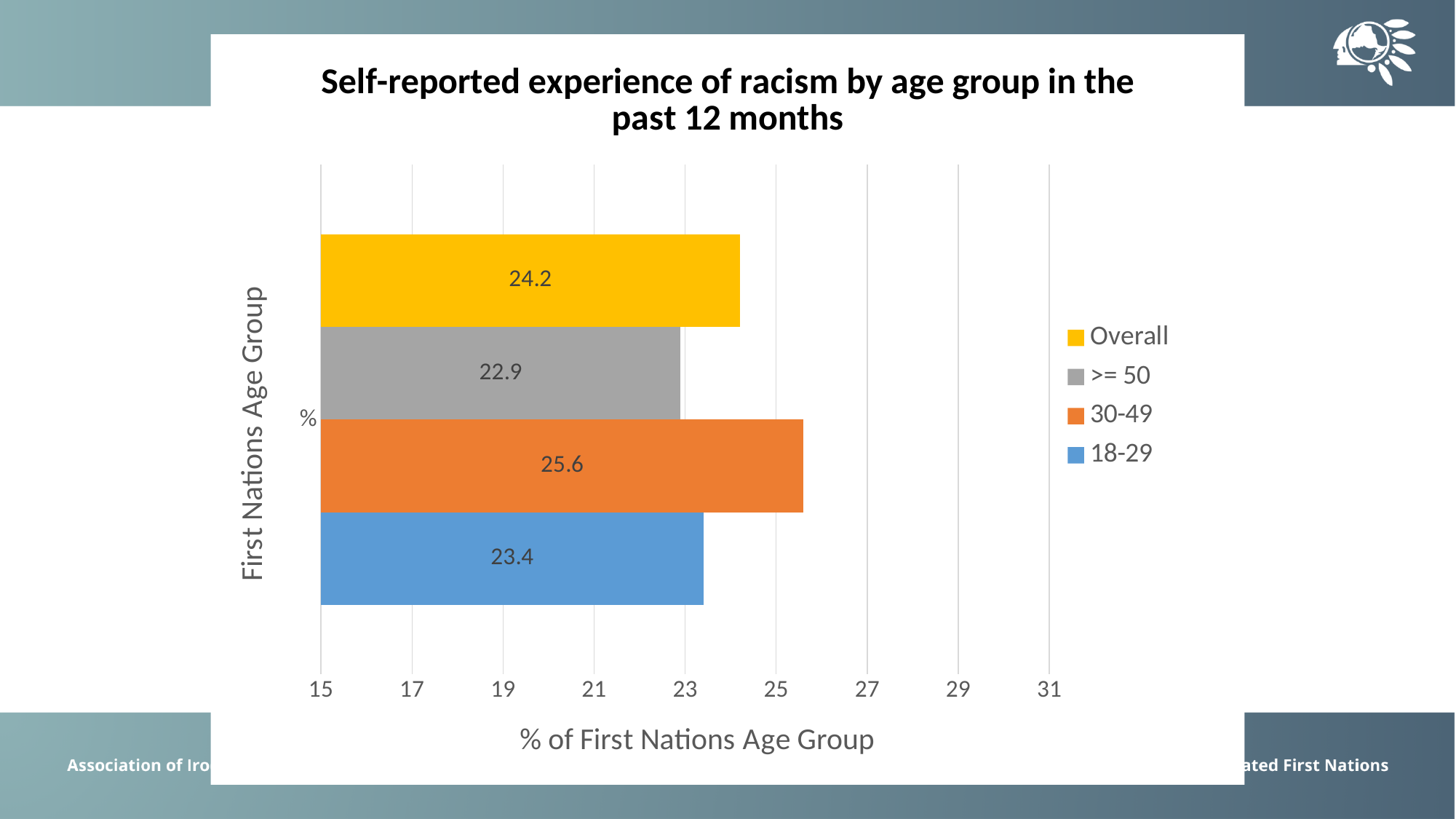
Which series has the lowest value? >= 50 What is the Overall value shown on the chart? 24.2 What is the value for the >= 50 age group? 22.9 What is the title of the chart? Self-reported experience of racism by age group in the past 12 months What colour is the bar for the 30-49 age group? Orange Which series has the highest value? 30-49 What is the difference between the 30-49 value and the >= 50 value? 2.7 What is the value for the 30-49 age group? 25.6 What kind of chart is shown on the slide? Bar chart What is the value for the 18-29 age group? 23.4 How many series does the legend list? 4 Which is larger, the value for 18-29 or the value for 30-49? 30-49